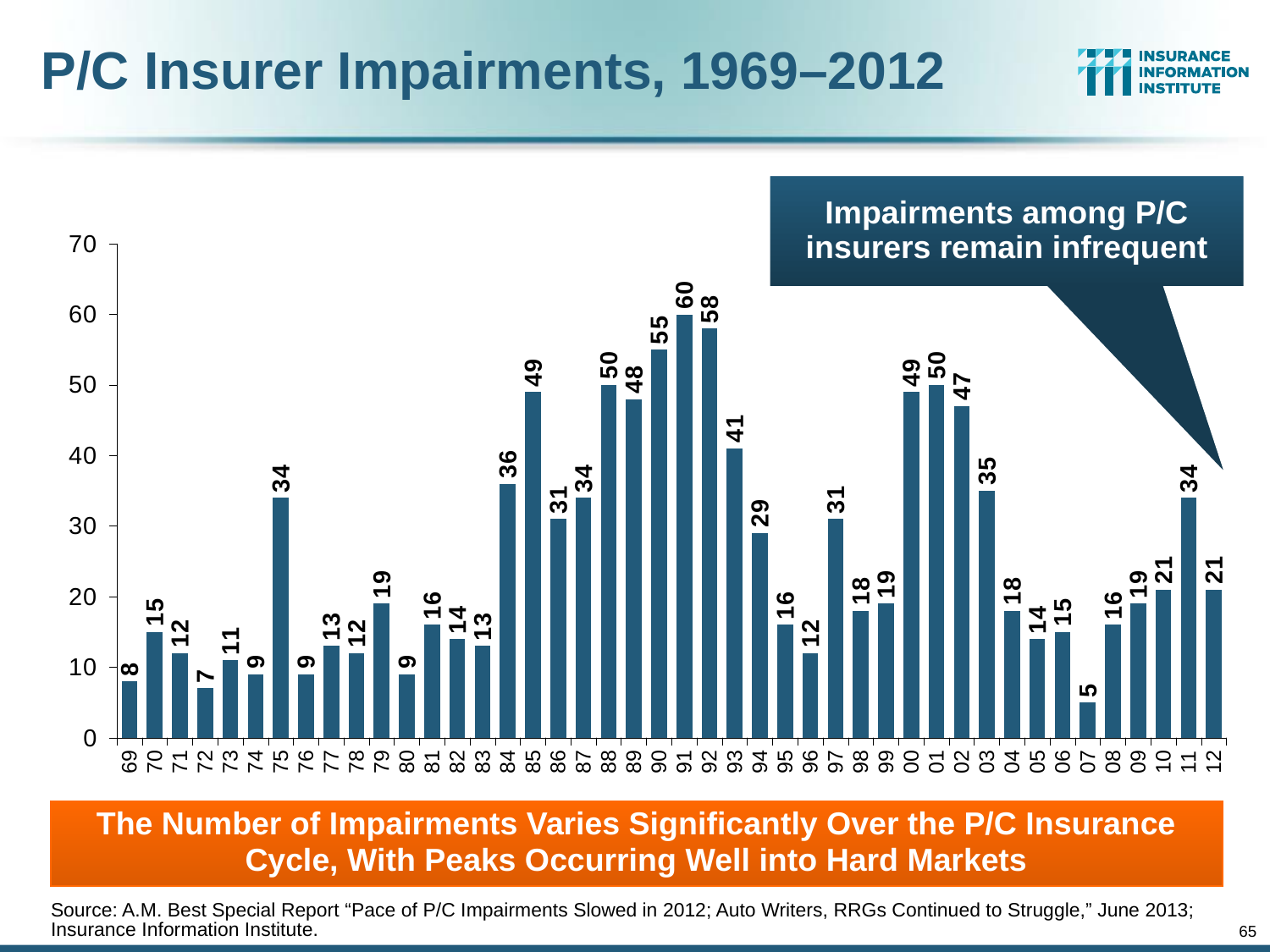
Which year has the highest number of impairments? 91 What type of chart is used to show P/C insurer impairments? Bar chart How many impairments are shown for 1975 (labelled '75')? 34 Which year has the lowest number of impairments? 07 How many years (bars) are plotted in the chart? 44 What is the difference between the impairments in 2001 ('01') and 2007 ('07')? 45 What is the number of impairments shown for 2012 (labelled '12')? 21 What is the difference between the impairments in 1991 ('91') and 1992 ('92')? 2 Is the value for 1990 ('90') greater or less than 50? greater What is the maximum value shown on the vertical axis? 70 Which year had more impairments, 1985 ('85') or 2002 ('02')? 85 What is the number of P/C insurer impairments in 1991 (labelled '91')? 60